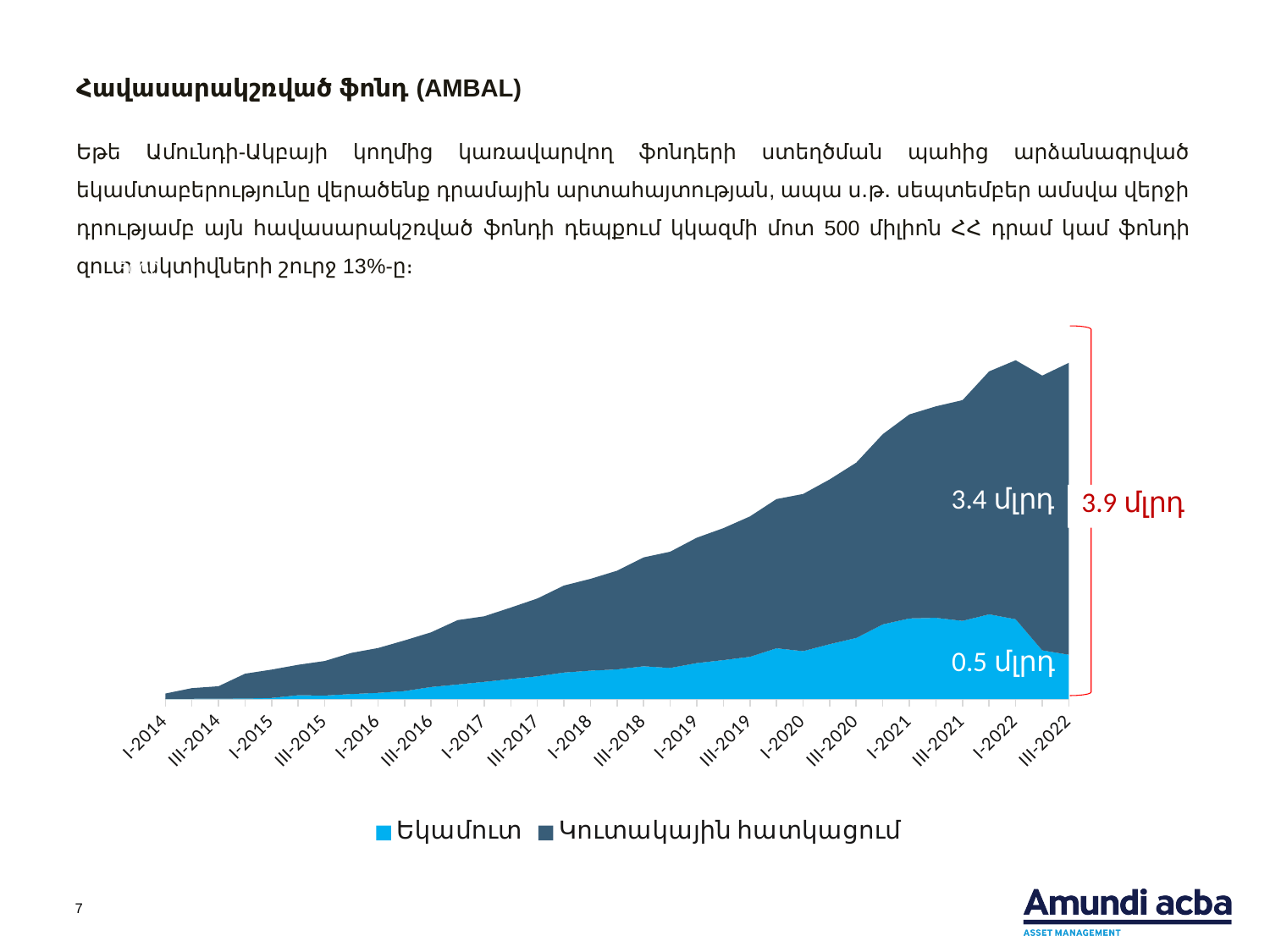
What is the value labelled for the Կուտակային հատկացում series at the end of the chart? 3.4 մլրդ Does the total value rise or fall from I-2014 to III-2022? Rise What is the last period labelled on the x axis? III-2022 What kind of chart is shown on the slide? Stacked area chart What is the value labelled for the Եկամուտ series at the end of the chart? 0.5 մլրդ Which series has the larger value at III-2022, Եկամուտ or Կուտակային հատկացում? Կուտակային հատկացում What is the difference between the Կուտակային հատկացում value and the Եկամուտ value at the end of the chart? 2.9 մլրդ Which series is drawn in light blue according to the legend? Եկամուտ How many series does the legend list? 2 What is the first period labelled on the x axis? I-2014 What is the total value shown at the right edge of the chart (III-2022)? 3.9 մլրդ How many period labels are shown on the x axis? 18